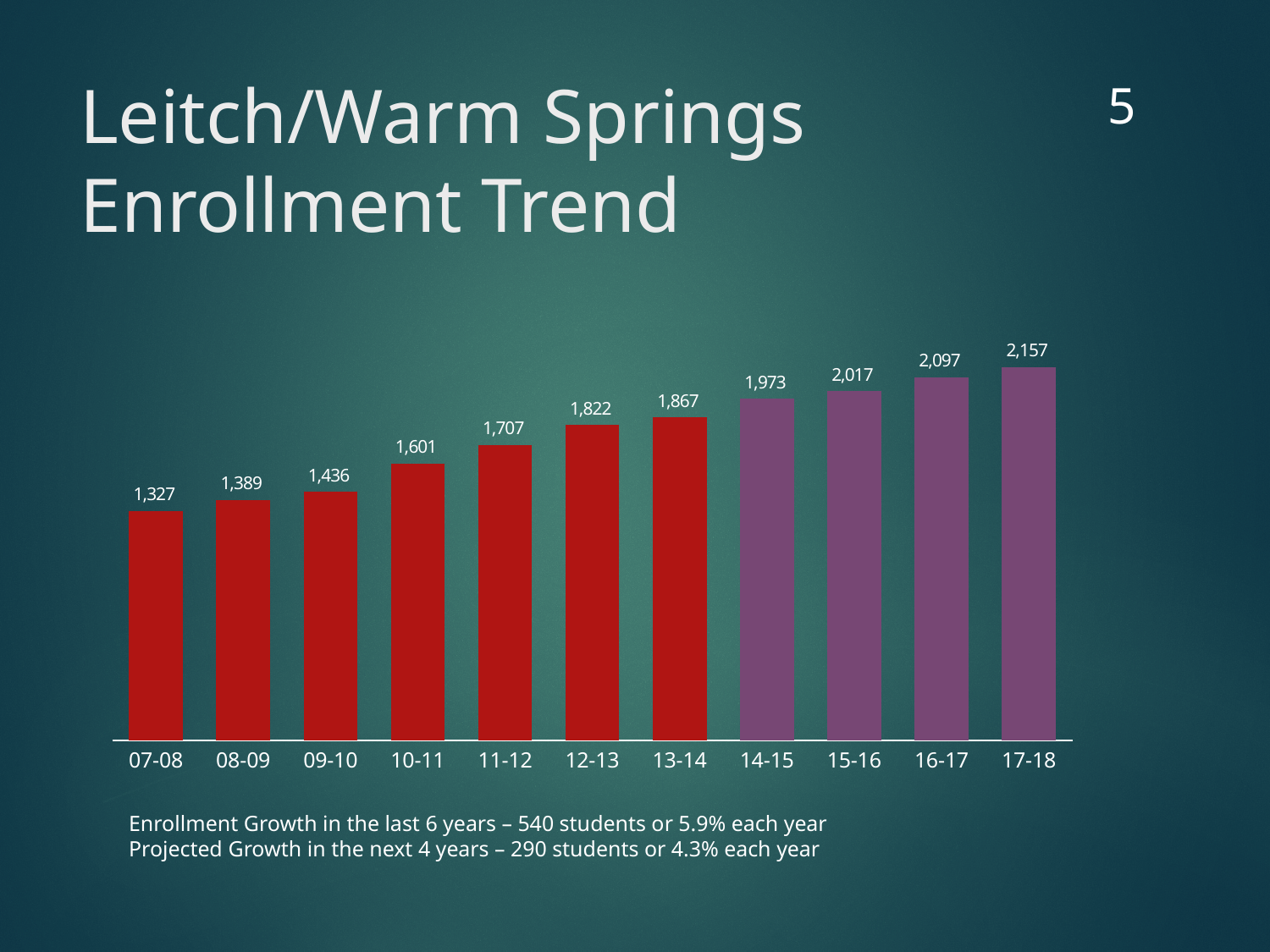
Which year has the lowest enrollment? 07-08 Which year has the highest enrollment? 17-18 How many years are shown on the x axis? 11 What is the difference in enrollment between 13-14 and 07-08? 540 What is the difference in enrollment between 17-18 and 13-14? 290 What is the enrollment value for 07-08? 1,327 Do the enrollment values rise or fall from 07-08 to 17-18? Rise What is the enrollment value for 17-18? 2,157 Which is larger, the enrollment for 10-11 or for 12-13? 12-13 What is the enrollment value for 13-14? 1,867 What kind of chart is shown on the slide? Bar chart How many bars are coloured purple rather than red? 4